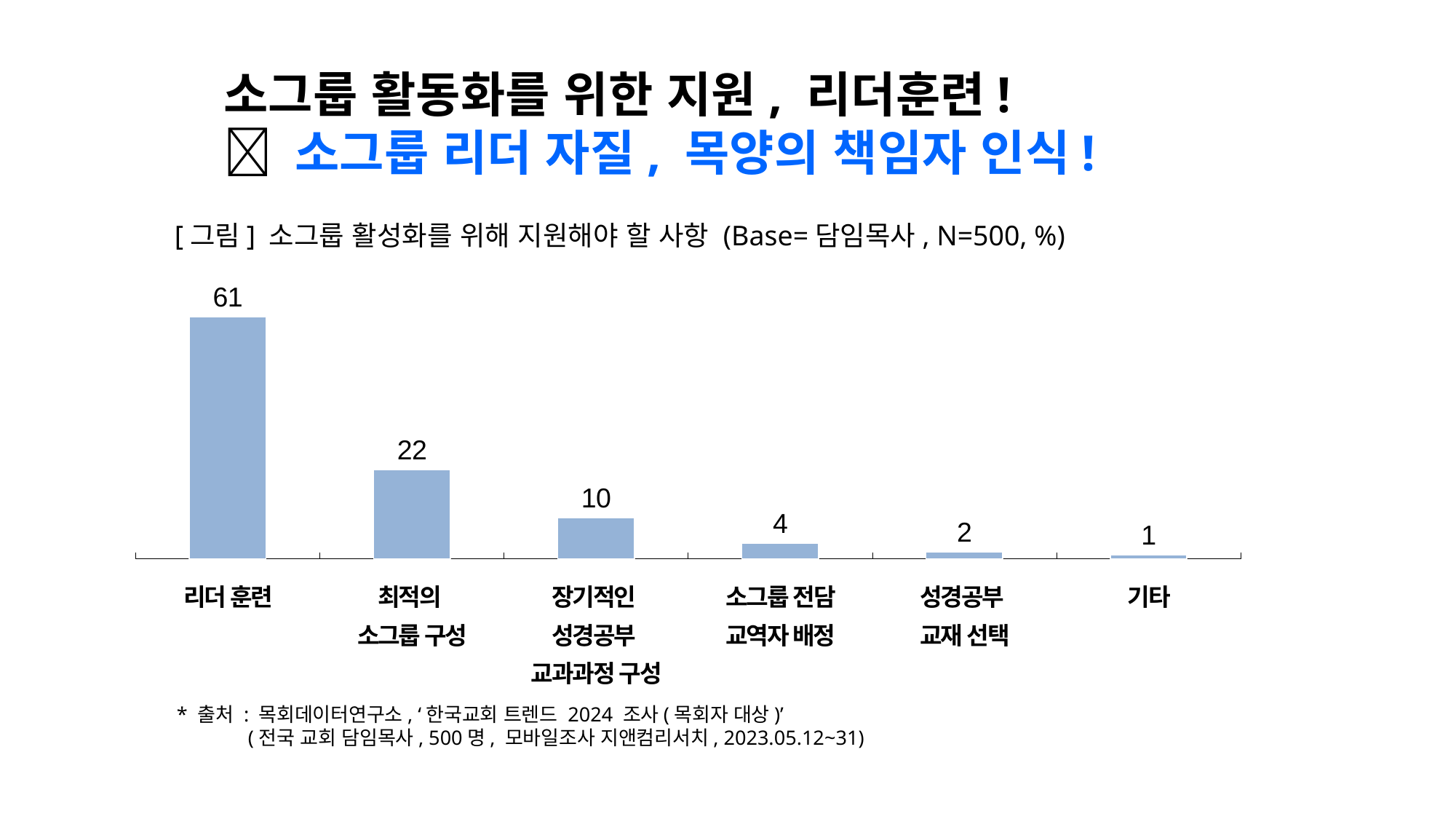
What kind of chart is shown on the slide? Bar chart Do the values rise or fall from left to right across the categories? Fall What is the value for 성경공부 교재 선택? 2 Which is larger, the value for 장기적인 성경공부 교과과정 구성 or the value for 소그룹 전담 교역자 배정? 장기적인 성경공부 교과과정 구성 How many categories are shown in the chart? 6 What is the difference between the values for 리더 훈련 and 최적의 소그룹 구성? 39 What is the value for 최적의 소그룹 구성? 22 What is the value for 리더 훈련? 61 What is the value for 소그룹 전담 교역자 배정? 4 Which category has the highest value? 리더 훈련 What is the value for 장기적인 성경공부 교과과정 구성? 10 Which category has the lowest value? 기타